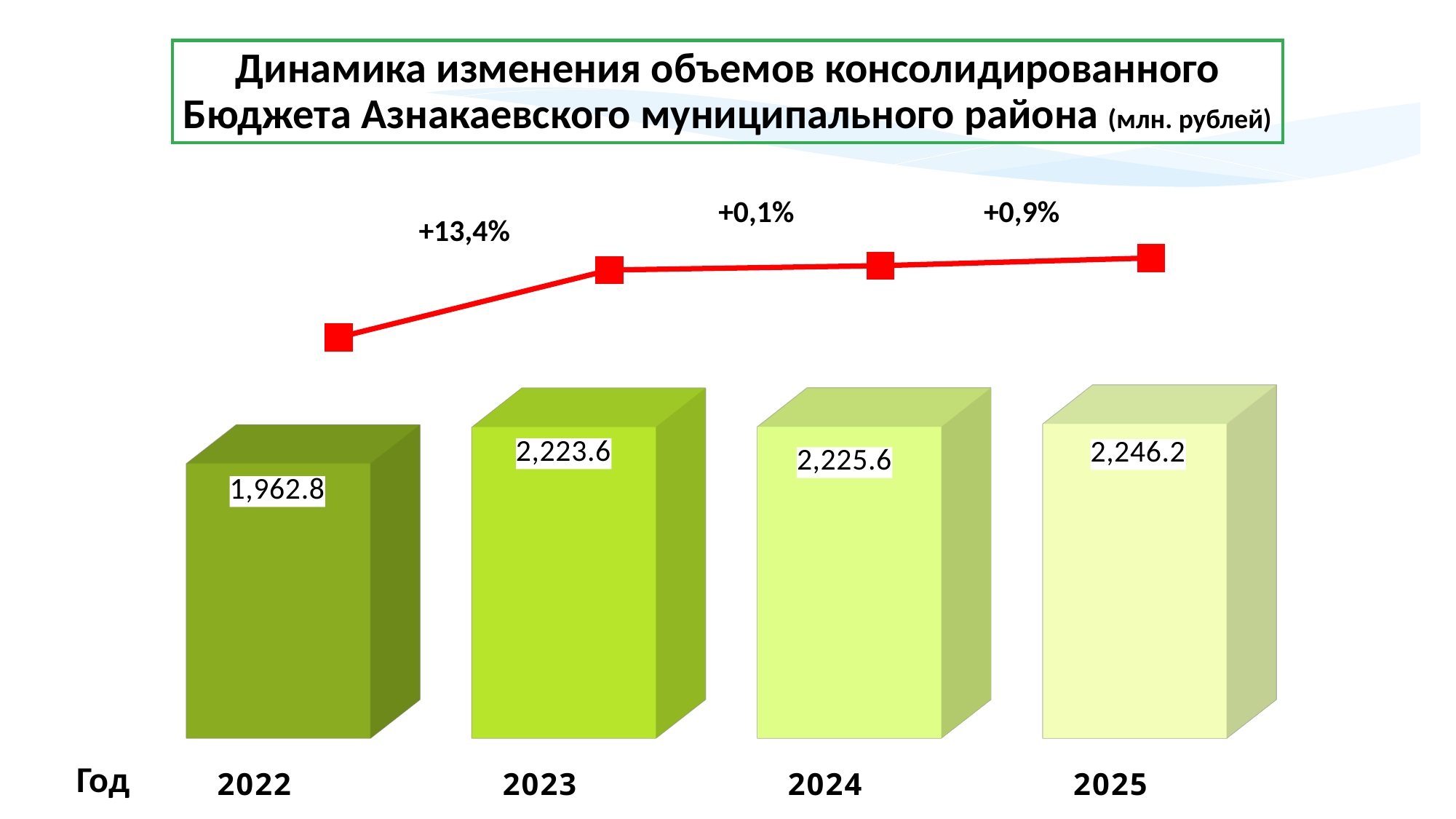
What is the value for 2022? 1,962.8 Which year has the lowest value? 2022 Which year has the highest value? 2025 What is the difference between the values for 2023 and 2022? 260.8 Do the values rise or fall from 2022 to 2025? rise What percentage change is shown between 2022 and 2023? +13,4% How many years are shown on the chart? 4 Which is larger, the value for 2022 or the value for 2025? 2025 What is the value for 2023? 2,223.6 What percentage change is shown between 2024 and 2025? +0,9% What is the difference between the values for 2025 and 2022? 283.4 What is the value for 2025? 2,246.2